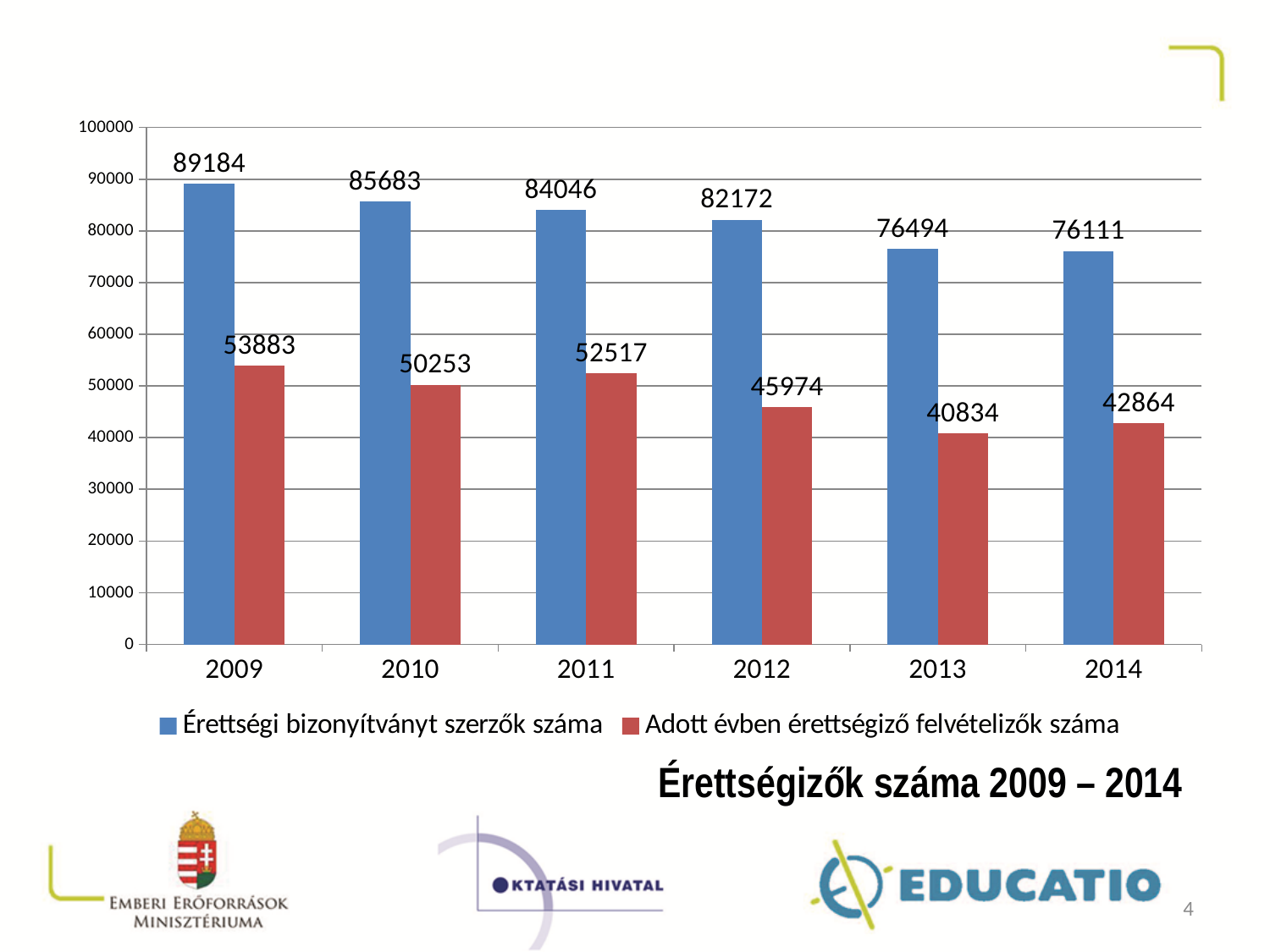
In which year is 'Érettségi bizonyítványt szerzők száma' highest? 2009 What kind of chart is shown on the slide? bar chart What is the difference between 'Érettségi bizonyítványt szerzők száma' and 'Adott évben érettségiző felvételizők száma' in 2011? 31529 What is the value of 'Érettségi bizonyítványt szerzők száma' for 2009? 89184 How many years are shown on the x axis? 6 How many series does the legend list? 2 Does 'Érettségi bizonyítványt szerzők száma' rise or fall from 2009 to 2014? fall What is the value of 'Adott évben érettségiző felvételizők száma' for 2012? 45974 In which year is 'Adott évben érettségiző felvételizők száma' lowest? 2013 Which is larger: 'Adott évben érettségiző felvételizők száma' in 2010 or in 2011? 2011 Is the value of 'Érettségi bizonyítványt szerzők száma' for 2013 greater or less than 80000? less What is the value of 'Érettségi bizonyítványt szerzők száma' for 2014? 76111